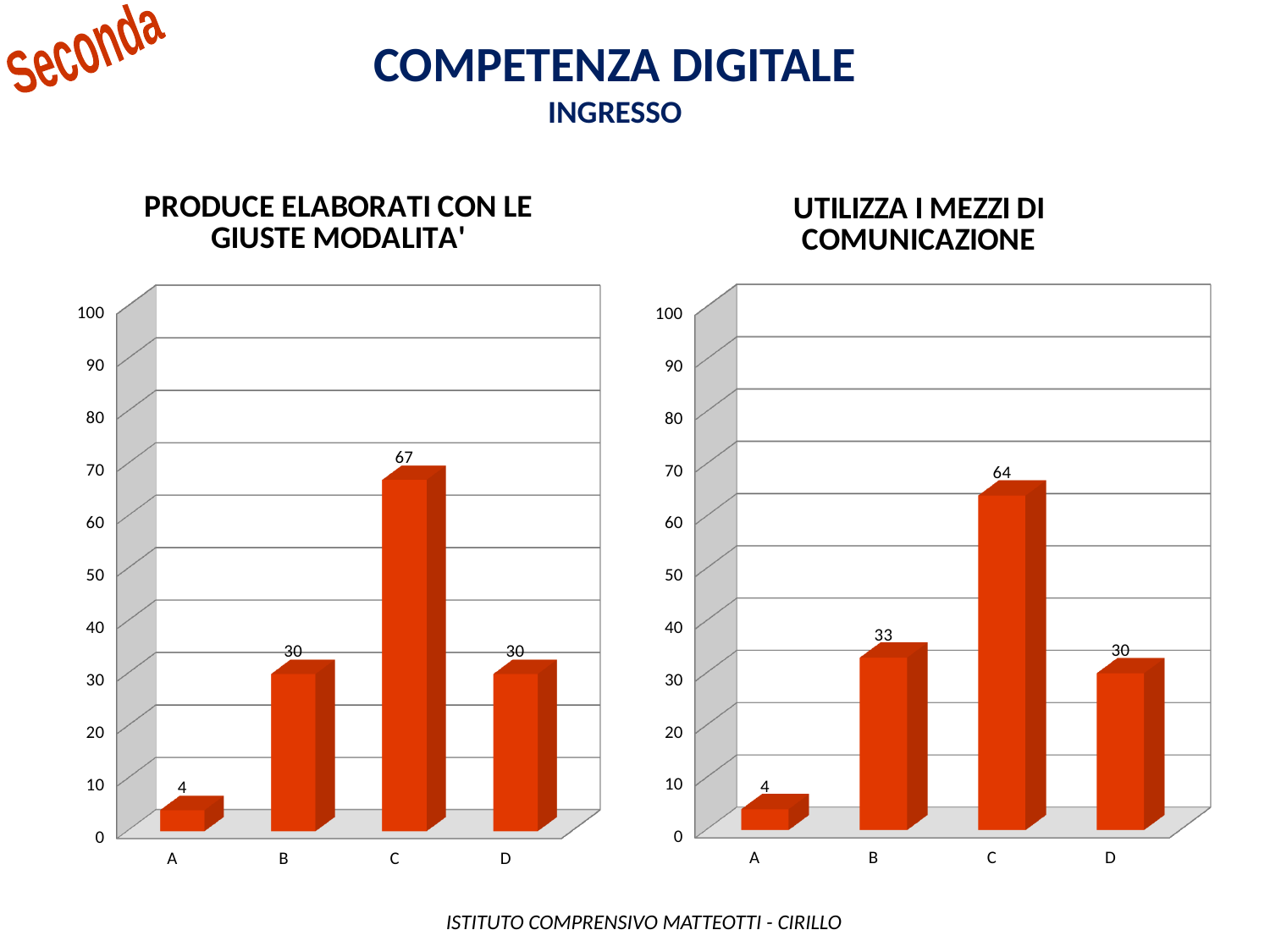
In the chart 'UTILIZZA I MEZZI DI COMUNICAZIONE', which is larger, the value for B or the value for D? B What kind of chart is 'PRODUCE ELABORATI CON LE GIUSTE MODALITA''? bar chart In the chart 'UTILIZZA I MEZZI DI COMUNICAZIONE', what is the value for category B? 33 In the chart 'PRODUCE ELABORATI CON LE GIUSTE MODALITA'', what is the value for category A? 4 How many categories are shown in the chart 'UTILIZZA I MEZZI DI COMUNICAZIONE'? 4 In the chart 'PRODUCE ELABORATI CON LE GIUSTE MODALITA'', what is the difference between the values for C and B? 37 In the chart 'PRODUCE ELABORATI CON LE GIUSTE MODALITA'', what is the value for category C? 67 In the chart 'UTILIZZA I MEZZI DI COMUNICAZIONE', what is the difference between the values for C and D? 34 In the chart 'PRODUCE ELABORATI CON LE GIUSTE MODALITA'', is the value for C greater or less than 60? greater What is the main title of the slide? COMPETENZA DIGITALE In the chart 'PRODUCE ELABORATI CON LE GIUSTE MODALITA'', which category has the lowest value? A In the chart 'UTILIZZA I MEZZI DI COMUNICAZIONE', which category has the highest value? C